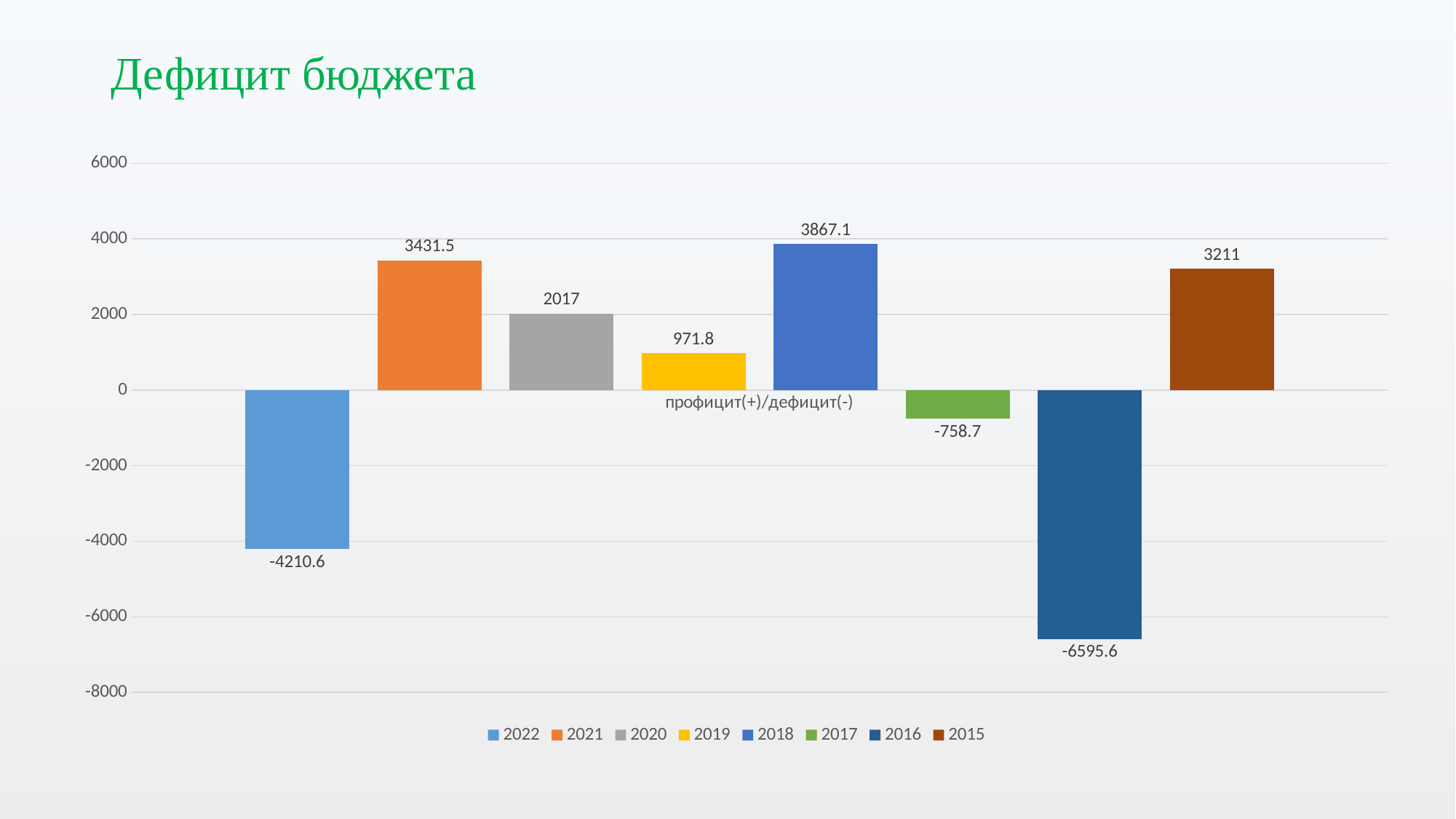
What is the title of the slide? Дефицит бюджета Which is larger, the value for 2020 or the value for 2019? 2020 What is the difference between the values for 2021 and 2015? 220.5 How many years are shown in the chart? 8 What kind of chart is shown on the slide? bar chart How many entries does the legend list? 8 Which year has the lowest value? 2016 What is the value for 2016? -6595.6 What is the value for 2022? -4210.6 Which year has the highest value? 2018 What is the value for 2019? 971.8 What is the value for 2018? 3867.1